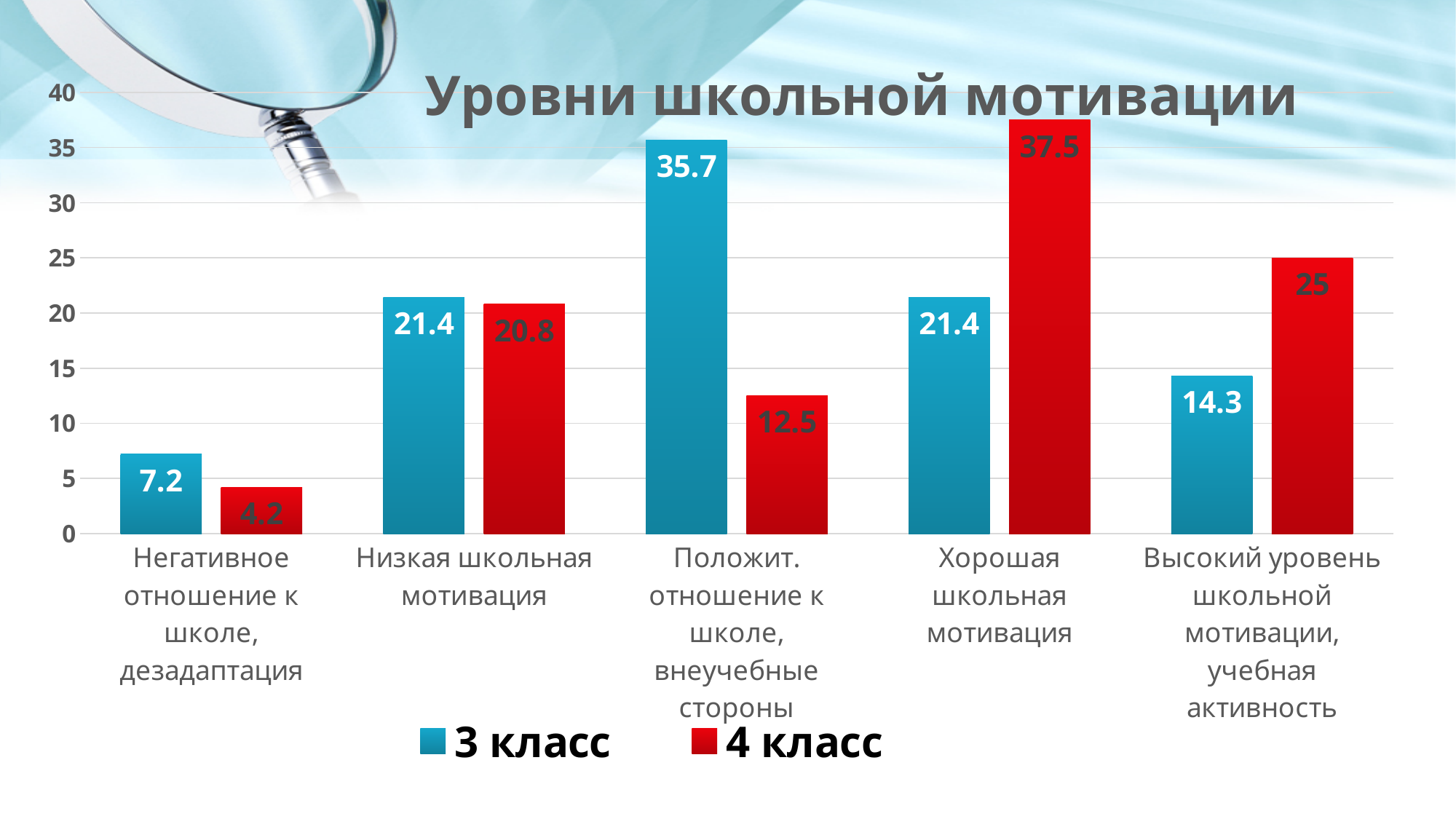
What is the value for 3 класс in the category Высокий уровень школьной мотивации, учебная активность? 14.3 What is the difference between the 3 класс and 4 класс values in the category Положит. отношение к школе, внеучебные стороны? 23.2 Which category has the lowest value for 3 класс? Негативное отношение к школе, дезадаптация How many categories are shown on the x axis? 5 What kind of chart is shown on the slide? Bar chart What is the title of the chart? Уровни школьной мотивации Which category has the highest value for 4 класс? Хорошая школьная мотивация How many series does the legend list? 2 In the category Высокий уровень школьной мотивации, учебная активность, which series has the larger value, 3 класс or 4 класс? 4 класс What is the value for 4 класс in the category Хорошая школьная мотивация? 37.5 What is the value for 4 класс in the category Негативное отношение к школе, дезадаптация? 4.2 What is the value for 3 класс in the category Положит. отношение к школе, внеучебные стороны? 35.7